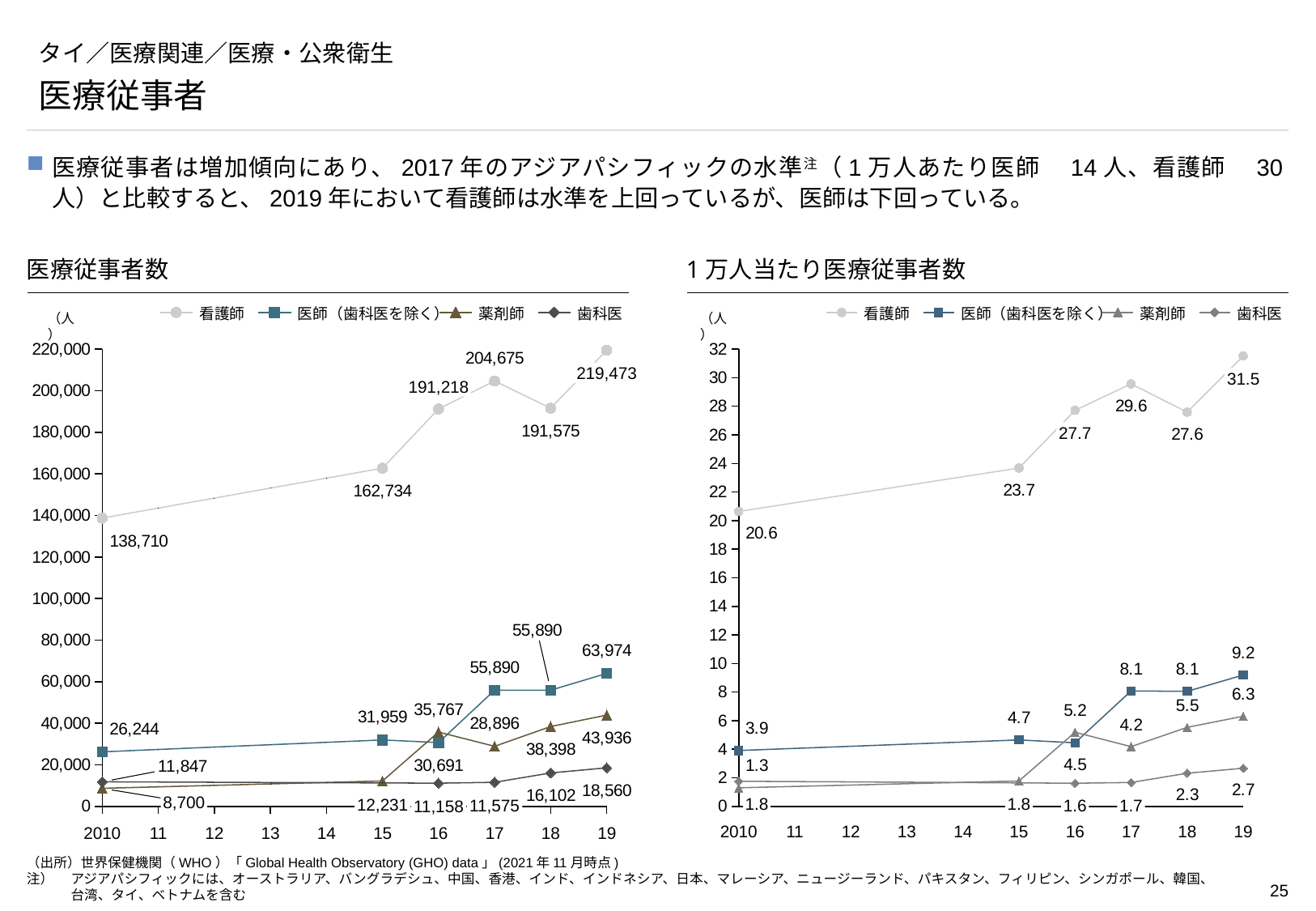
In the 1万人当たり医療従事者数 chart on the right, what is the value for 看護師 in 2017? 29.6 In the 医療従事者数 chart on the left, what is the value for 医師（歯科医を除く） in 2010? 26,244 What kind of chart is the 医療従事者数 chart on the left? line chart In the 1万人当たり医療従事者数 chart on the right, what is the value for 医師（歯科医を除く） in 2019? 9.2 In the 医療従事者数 chart on the left, how many series does the legend list? 4 In the 医療従事者数 chart on the left, in which year is the 看護師 value highest? 2019 In the 1万人当たり医療従事者数 chart on the right, is the 看護師 value in 2019 greater or less than 30? greater In the 1万人当たり医療従事者数 chart on the right, what is the value for 歯科医 in 2019? 2.7 In the 1万人当たり医療従事者数 chart on the right, which is larger in 2019: 薬剤師 or 歯科医? 薬剤師 In the 医療従事者数 chart on the left, what is the difference between the 看護師 values in 2019 and 2010? 80,763 In the 医療従事者数 chart on the left, what is the value for 看護師 in 2019? 219,473 In the 医療従事者数 chart on the left, what is the value for 薬剤師 in 2019? 43,936